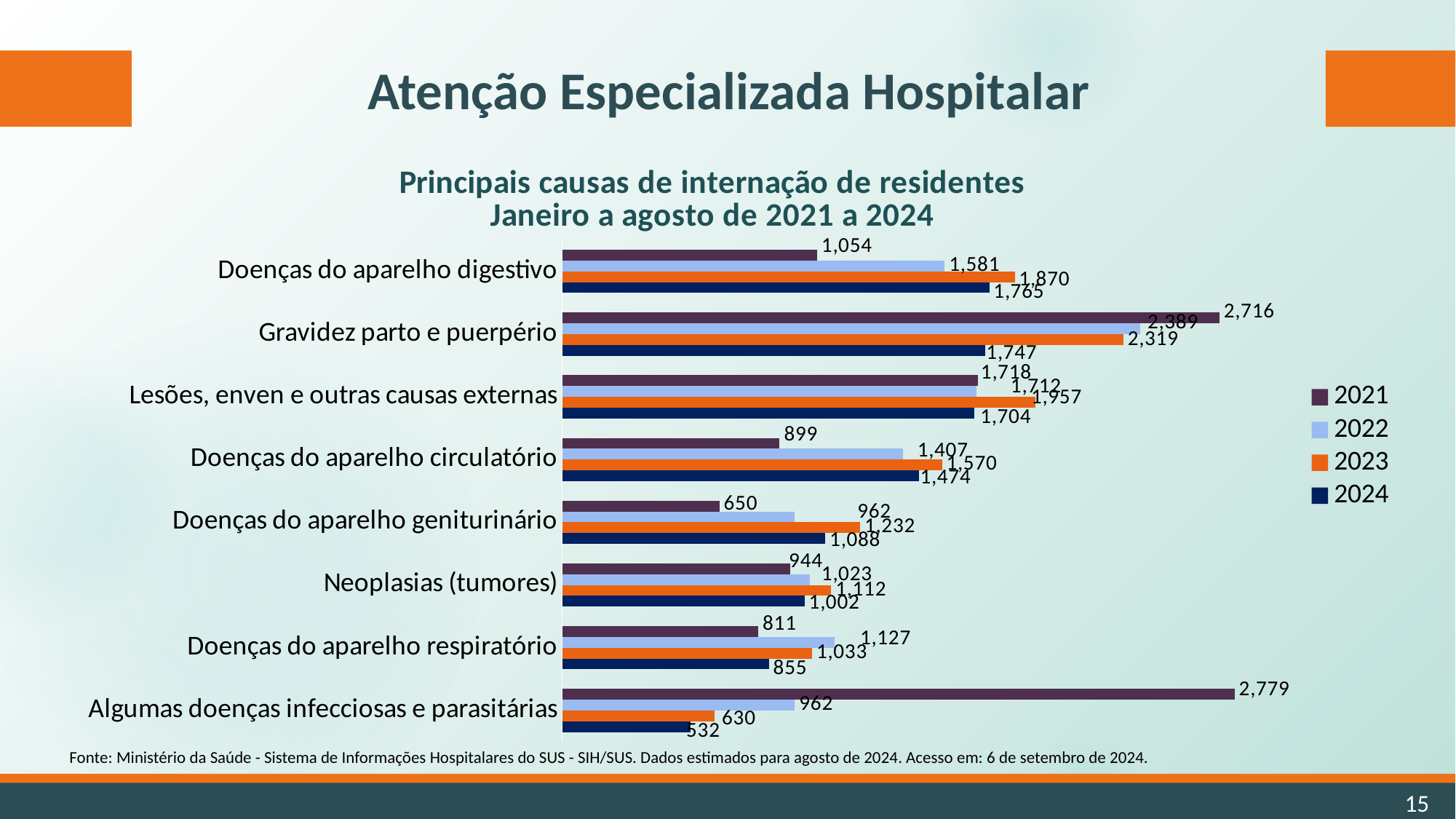
What is the 2021 value for Gravidez parto e puerpério? 2,716 Which is larger for 2023: Doenças do aparelho digestivo or Lesões, enven e outras causas externas? Lesões, enven e outras causas externas How many categories (causes) are shown on the chart? 8 What is the difference between the 2021 and 2024 values for Algumas doenças infecciosas e parasitárias? 2,247 Which category has the highest value for 2021? Algumas doenças infecciosas e parasitárias How many series does the legend list? 4 Which years are listed in the chart legend? 2021, 2022, 2023, 2024 Which category has the lowest value for 2024? Algumas doenças infecciosas e parasitárias What kind of chart is shown on the slide? Bar chart What is the 2024 value for Algumas doenças infecciosas e parasitárias? 532 What is the 2023 value for Doenças do aparelho geniturinário? 1,232 Do the values for Algumas doenças infecciosas e parasitárias rise or fall from 2021 to 2024? Fall